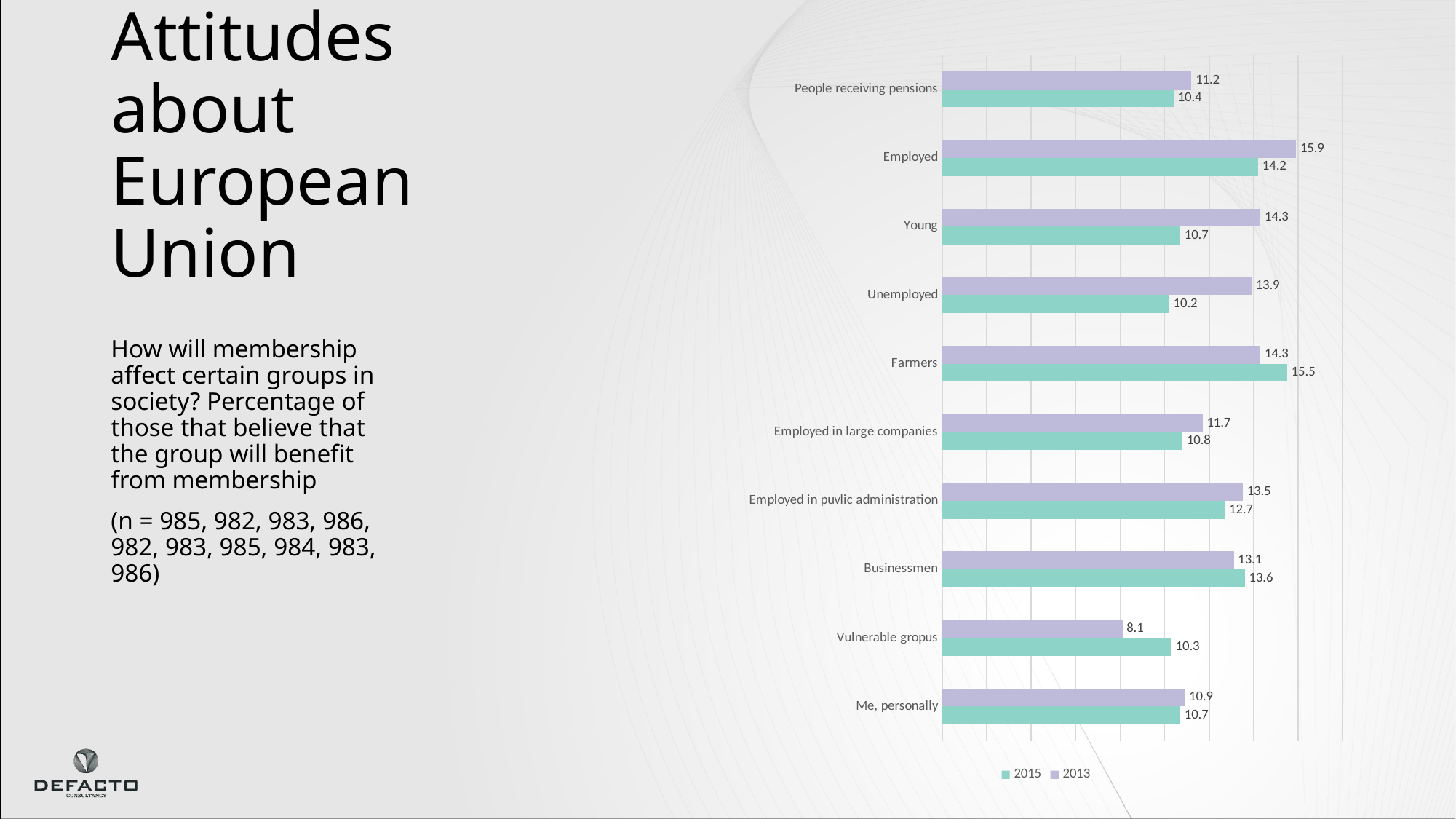
What is the 2013 value for Employed? 15.9 Which series is shown in purple? 2013 How many categories are shown in the chart? 10 What is the difference between the 2013 and 2015 values for Young? 3.6 Which category has the lowest 2013 value? Vulnerable gropus Which is larger for Businessmen, the 2013 value or the 2015 value? 2015 What is the 2015 value for Farmers? 15.5 What is the 2015 value for Vulnerable gropus? 10.3 Which category has the highest 2015 value? Farmers How many series does the legend list? 2 What kind of chart is shown on the slide? Bar chart Which category has the highest 2013 value? Employed